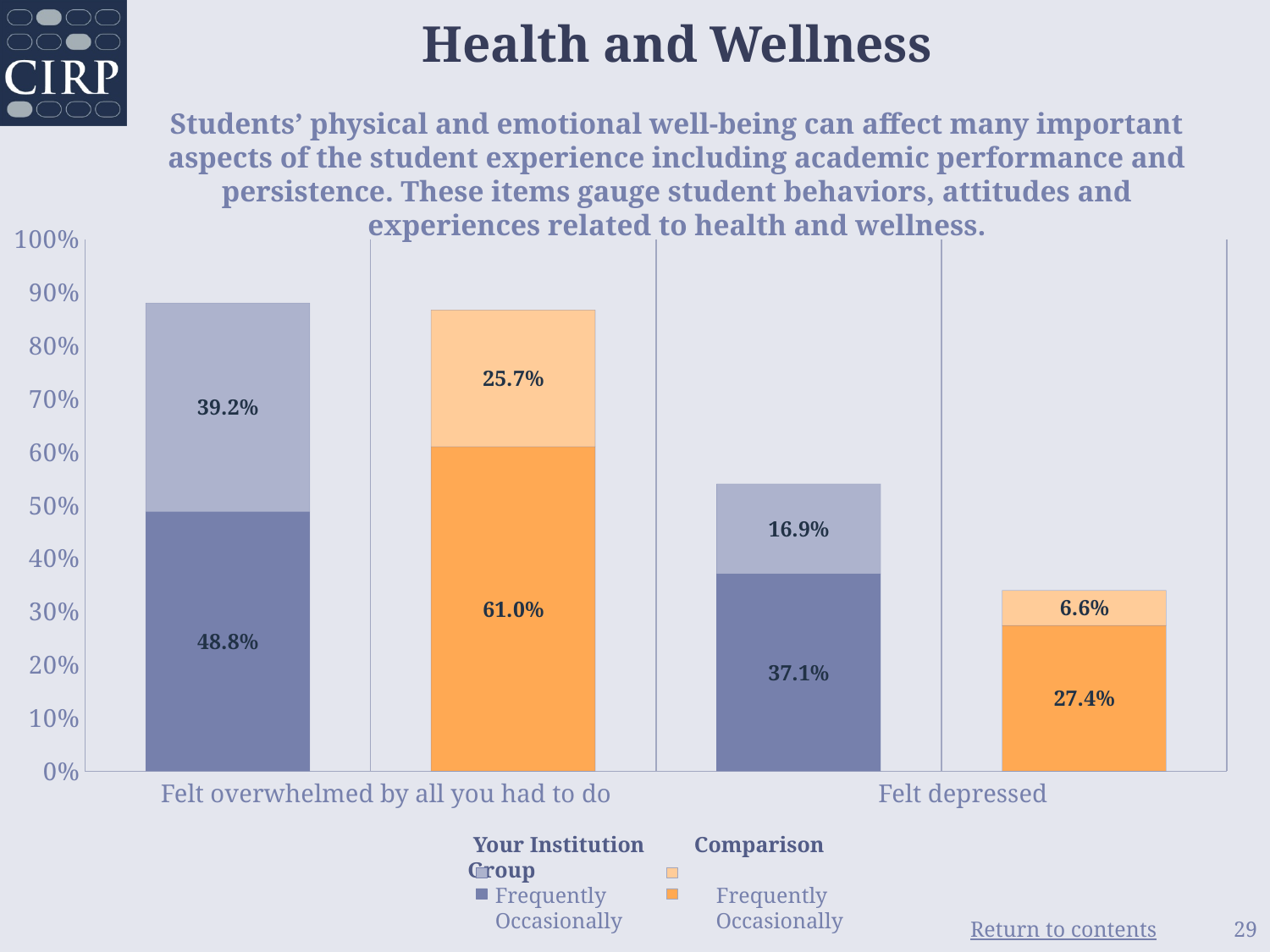
What percentage of the Comparison Group reported occasionally feeling depressed? 6.6% What type of chart is shown on the slide? Stacked bar chart Which group has the larger percentage of students who frequently felt depressed, Your Institution or the Comparison Group? Your Institution What percentage of students at Your Institution reported frequently feeling overwhelmed by all they had to do? 48.8% Which of the two items has the lowest total stacked bar for the Comparison Group? Felt depressed What is the total percentage of Your Institution students who felt overwhelmed by all they had to do (frequently plus occasionally)? 88.0% What percentage of students at Your Institution reported occasionally feeling depressed? 16.9% What is the difference between the Comparison Group and Your Institution in the percentage who frequently felt overwhelmed by all they had to do? 12.2% What is the total percentage of the Comparison Group who felt depressed (frequently plus occasionally)? 34.0% How many items (categories) are shown on the x axis of the chart? 2 How many series does the legend list? 4 What percentage of the Comparison Group reported frequently feeling overwhelmed by all they had to do? 61.0%